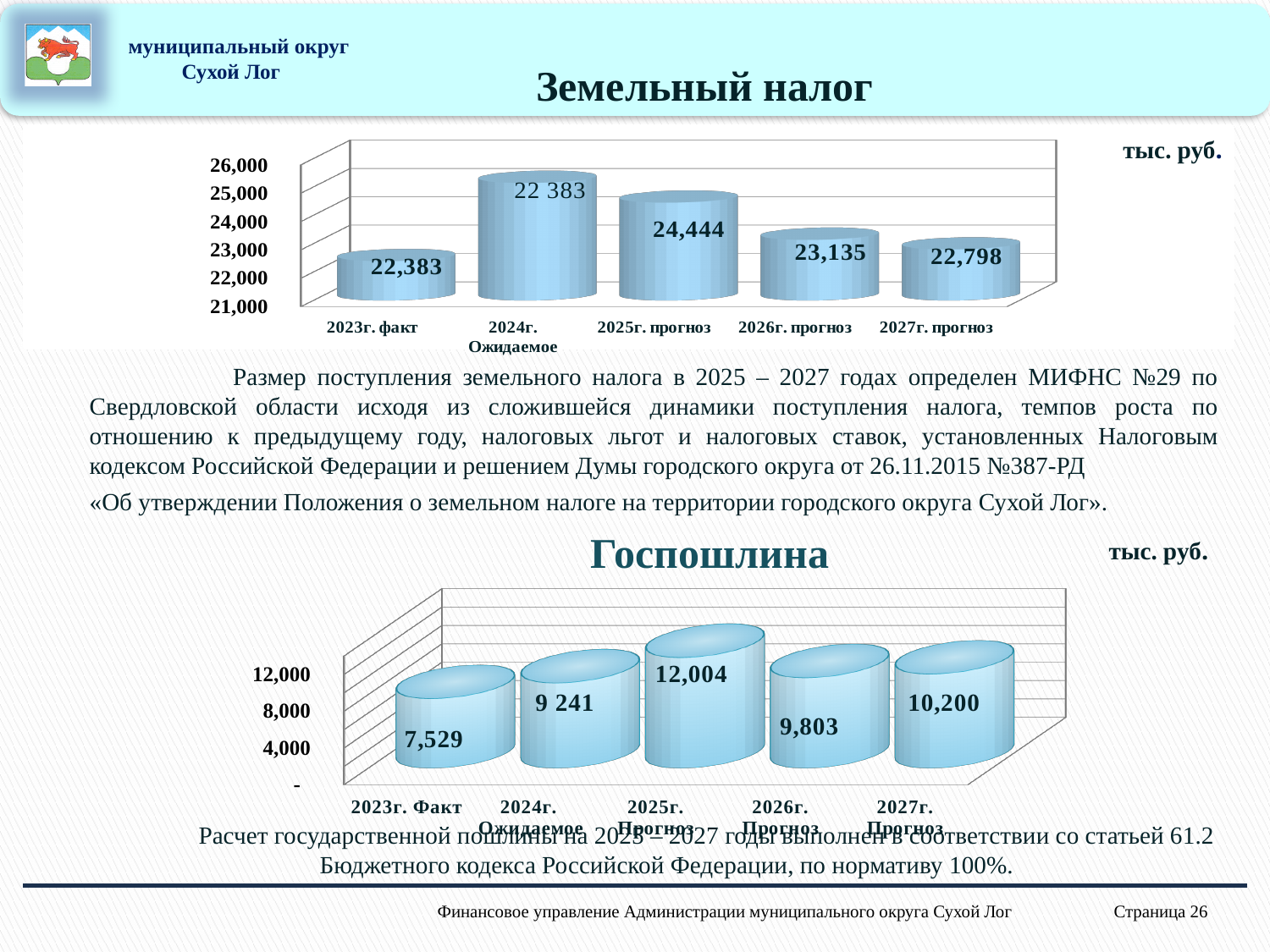
What kind of chart is the Земельный налог chart? bar chart What unit is indicated for the values in the Госпошлина chart? тыс. руб. In the Земельный налог chart, which is larger: the value for 2026г. прогноз or 2027г. прогноз? 2026г. прогноз How many categories are shown in the Земельный налог chart? 5 In the Госпошлина chart, what is the value for 2026г. Прогноз? 9,803 In the Земельный налог chart, what is the value for 2027г. прогноз? 22,798 In the Земельный налог chart, what is the difference between the values for 2025г. прогноз and 2026г. прогноз? 1,309 In the Госпошлина chart, what is the value for 2023г. Факт? 7,529 In the Госпошлина chart, which category has the lowest value? 2023г. Факт In the Госпошлина chart, what is the difference between the values for 2027г. Прогноз and 2026г. Прогноз? 397 In the Госпошлина chart, which category has the highest value? 2025г. Прогноз In the Земельный налог chart, what is the value for 2025г. прогноз? 24,444